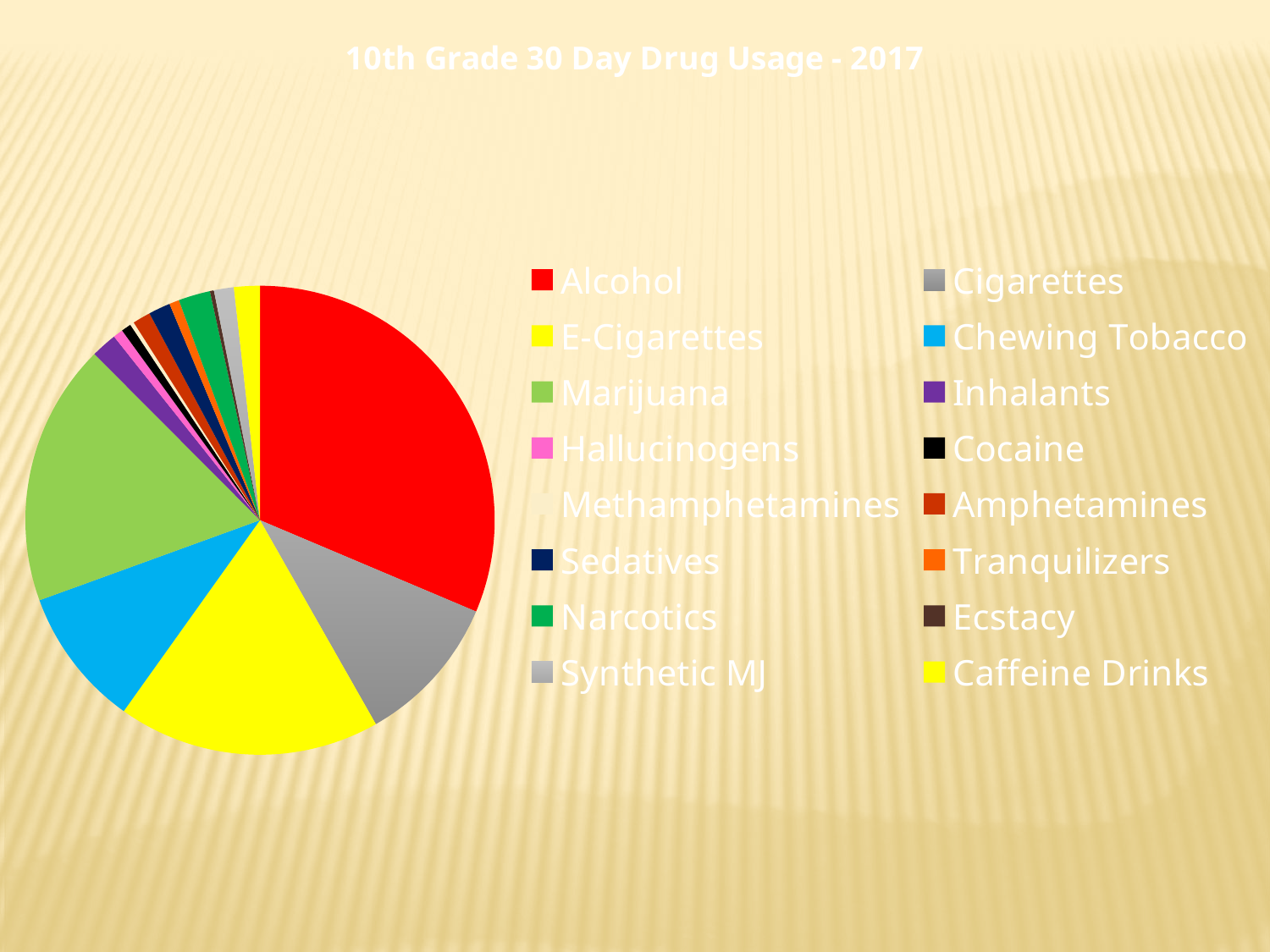
Which slice is larger, Marijuana or Inhalants? Marijuana Which slice is larger, Alcohol or Cigarettes? Alcohol Which slice is larger, Alcohol or Marijuana? Alcohol How many categories does the legend of the pie chart list? 16 What is the title of the chart? 10th Grade 30 Day Drug Usage - 2017 What kind of chart is shown on the slide? pie chart Which category has the largest slice of the pie? Alcohol What colour represents Alcohol in the pie chart? red